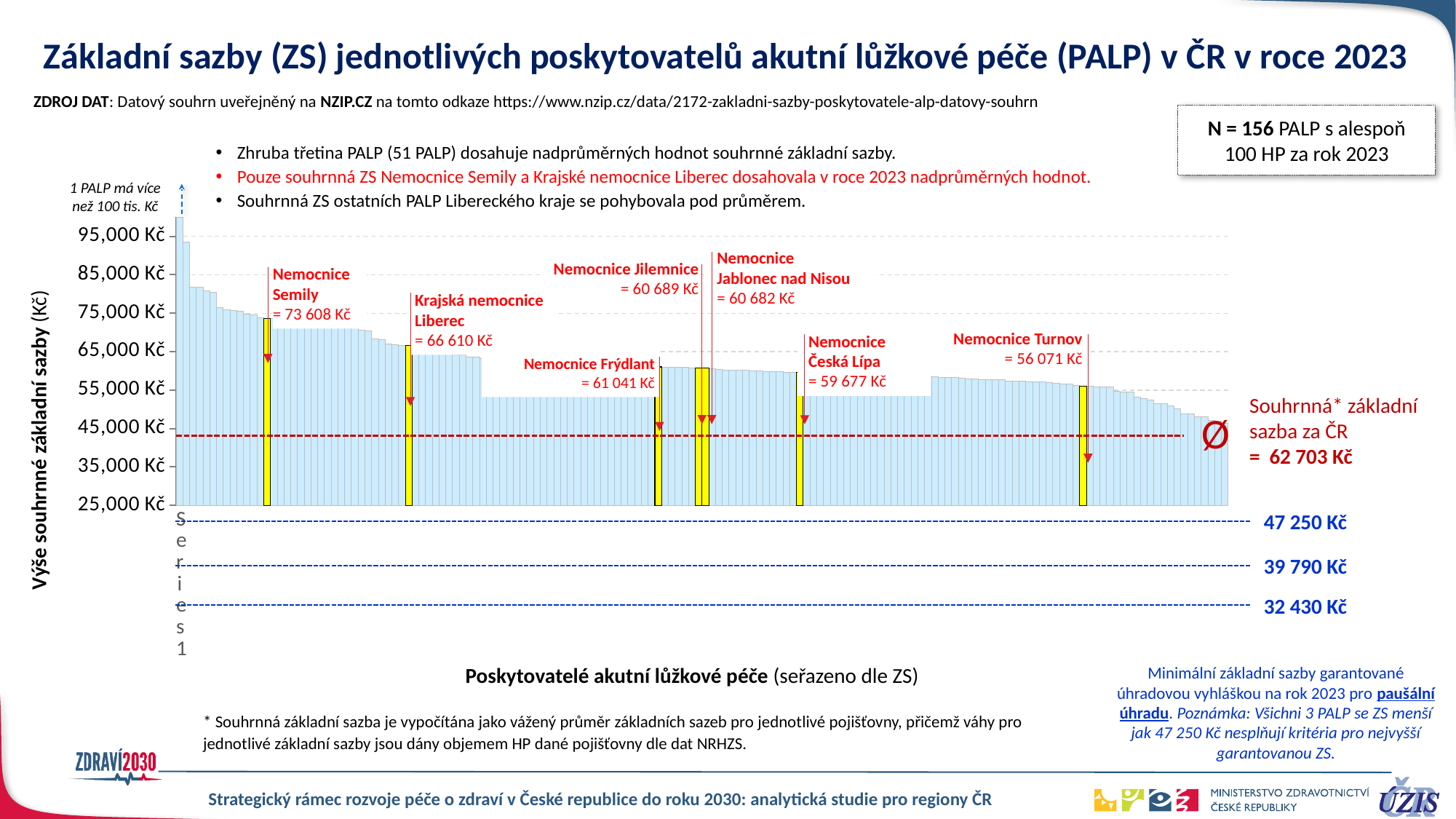
Do the values rise or fall from left to right along the x axis? fall What is the value shown for Krajská nemocnice Liberec? 66 610 Kč What is the value shown for Nemocnice Turnov? 56 071 Kč What kind of chart is shown on the slide? bar chart What is the value shown for Nemocnice Semily? 73 608 Kč What is the difference between the values for Nemocnice Semily and Krajská nemocnice Liberec? 6 998 Kč What is the value shown for Nemocnice Jilemnice? 60 689 Kč What is the label of the y axis of the chart? Výše souhrnné základní sazby (Kč) Which is larger, the value for Nemocnice Frýdlant or the value for Nemocnice Turnov? Nemocnice Frýdlant How many PALP (providers) are included in the chart according to the slide? 156 What is the value shown for Nemocnice Česká Lípa? 59 677 Kč Is the value for Nemocnice Turnov greater or less than 65,000 Kč? less